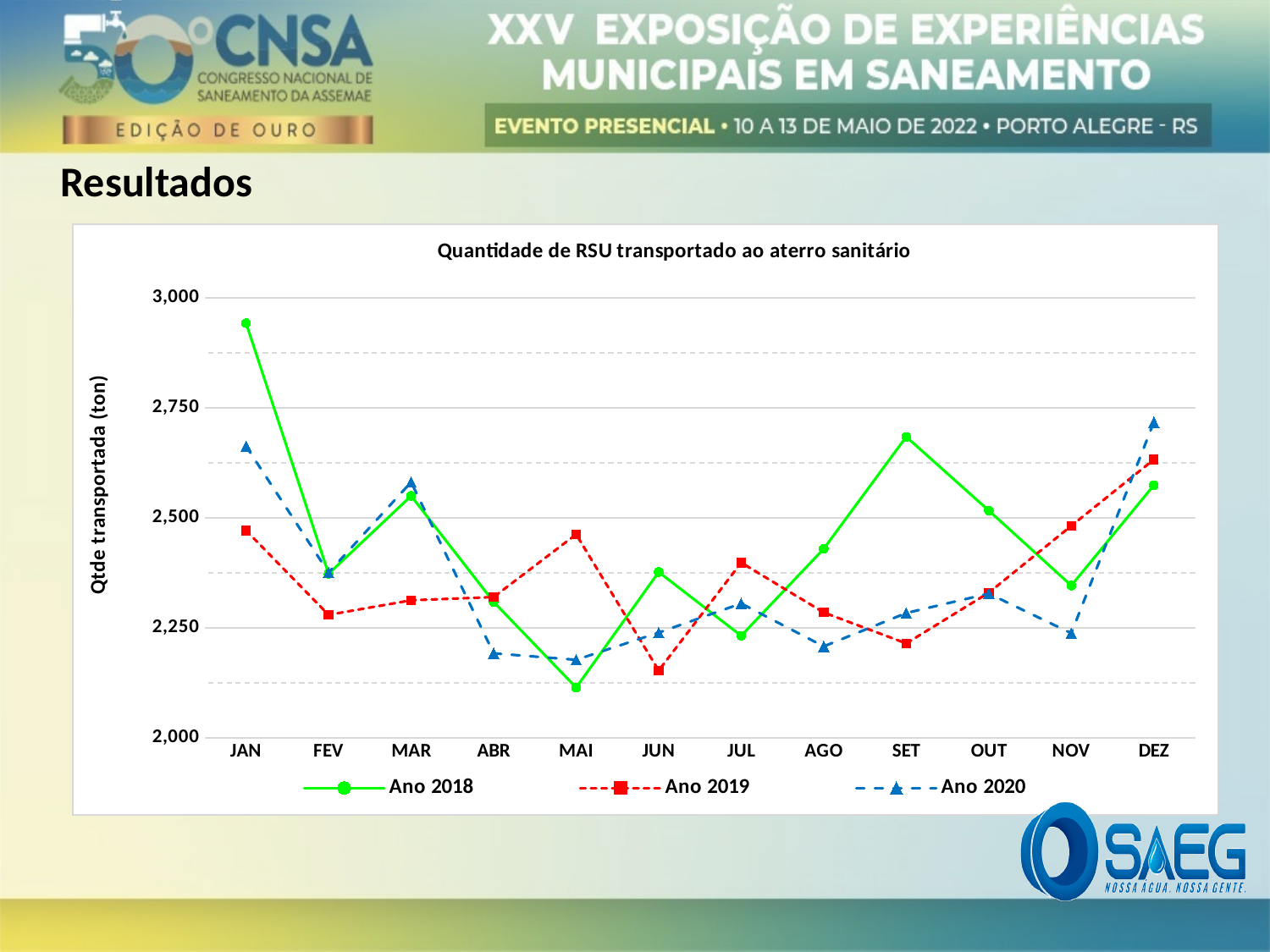
What is the title of the chart? Quantidade de RSU transportado ao aterro sanitário Does the Ano 2019 series rise or fall from SET to DEZ? Rise In which month does the Ano 2019 series reach its highest value? DEZ In MAI, which series has the larger value, Ano 2018 or Ano 2019? Ano 2019 In which month does the Ano 2018 series reach its highest value? JAN How many months are plotted along the x axis? 12 What is the label of the vertical axis? Qtde transportada (ton) Is the value for Ano 2018 in JAN greater or less than 2,750? greater What kind of chart is shown on the slide? Line chart How many series does the legend list? 3 In which month does the Ano 2018 series reach its lowest value? MAI Is the value for Ano 2020 in ABR greater or less than 2,250? less